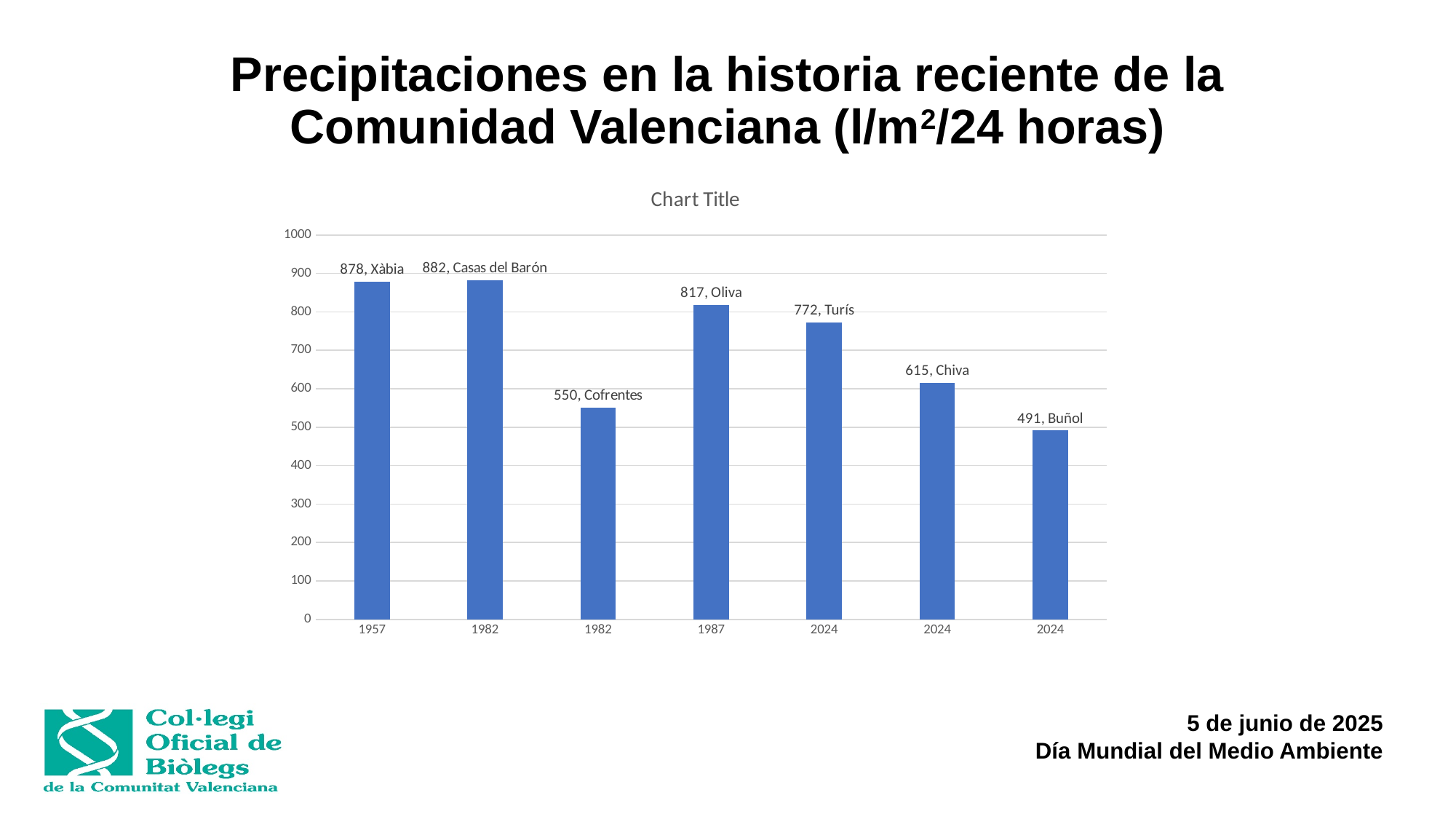
What is the precipitation value for Cofrentes? 550 Which location has the lowest precipitation value? Buñol What kind of chart is shown on the slide? bar chart What is the difference between the values for Chiva and Buñol? 124 What is the precipitation value for Buñol? 491 Which is larger, the value for Turís or the value for Chiva? Turís Which location has the highest precipitation value? Casas del Barón What is the difference between the values for Oliva and Turís? 45 What is the precipitation value for Xàbia? 878 What year is shown on the x axis for the Oliva bar? 1987 Is the value for Cofrentes greater or less than 600? less How many bars are shown in the chart? 7